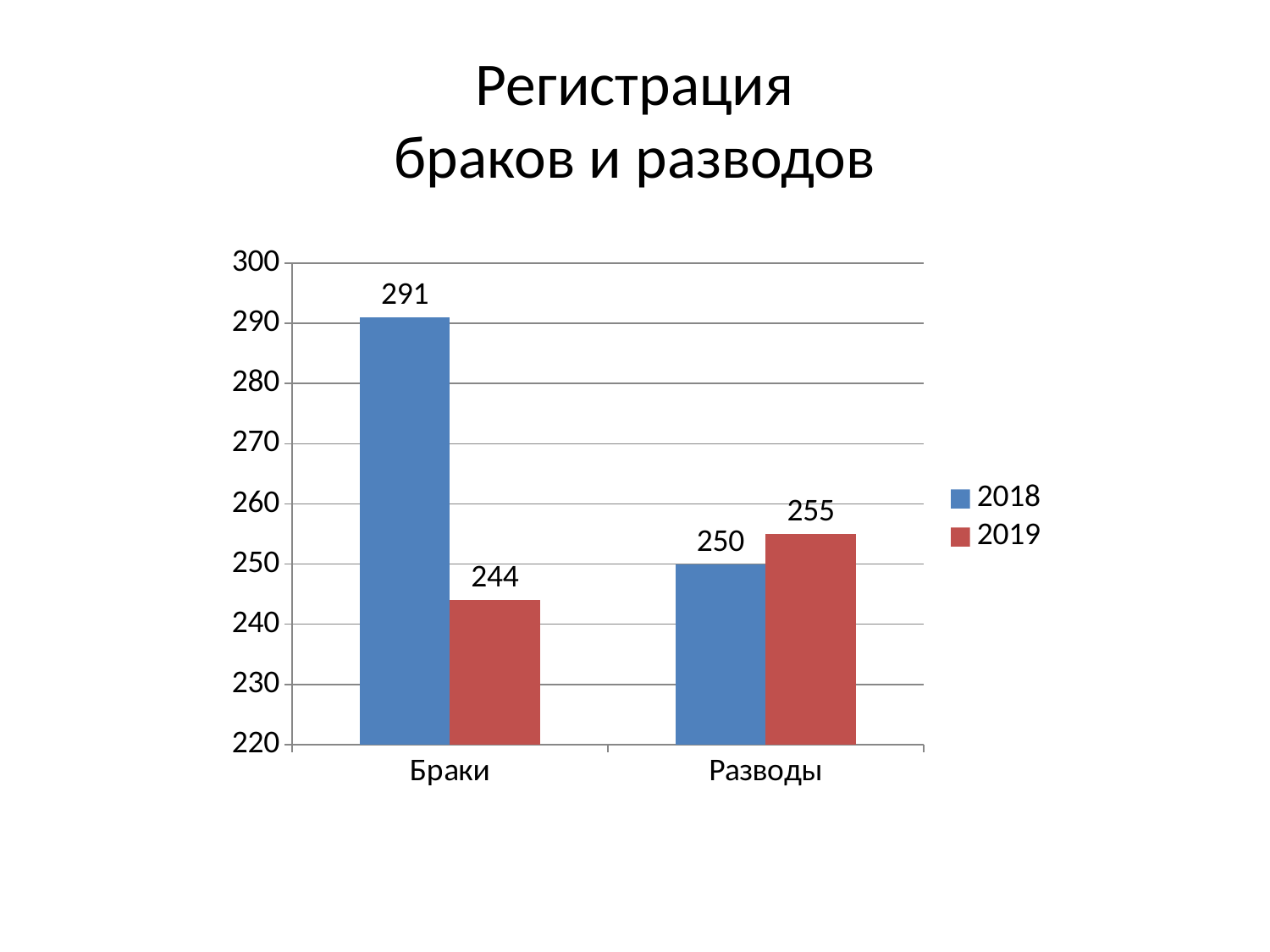
How many categories are shown on the x axis? 2 What is the value for Разводы in 2019? 255 What is the difference between the 2019 and 2018 values for Разводы? 5 How many series does the legend list? 2 Which category has the highest value in the 2018 series? Браки What is the value for Разводы in 2018? 250 Which category has the lowest value in the 2019 series? Браки What is the value for Браки in 2018? 291 Which is larger for Разводы: the 2018 value or the 2019 value? 2019 What kind of chart is shown on the slide? Bar chart What is the value for Браки in 2019? 244 What is the difference between the 2018 and 2019 values for Браки? 47